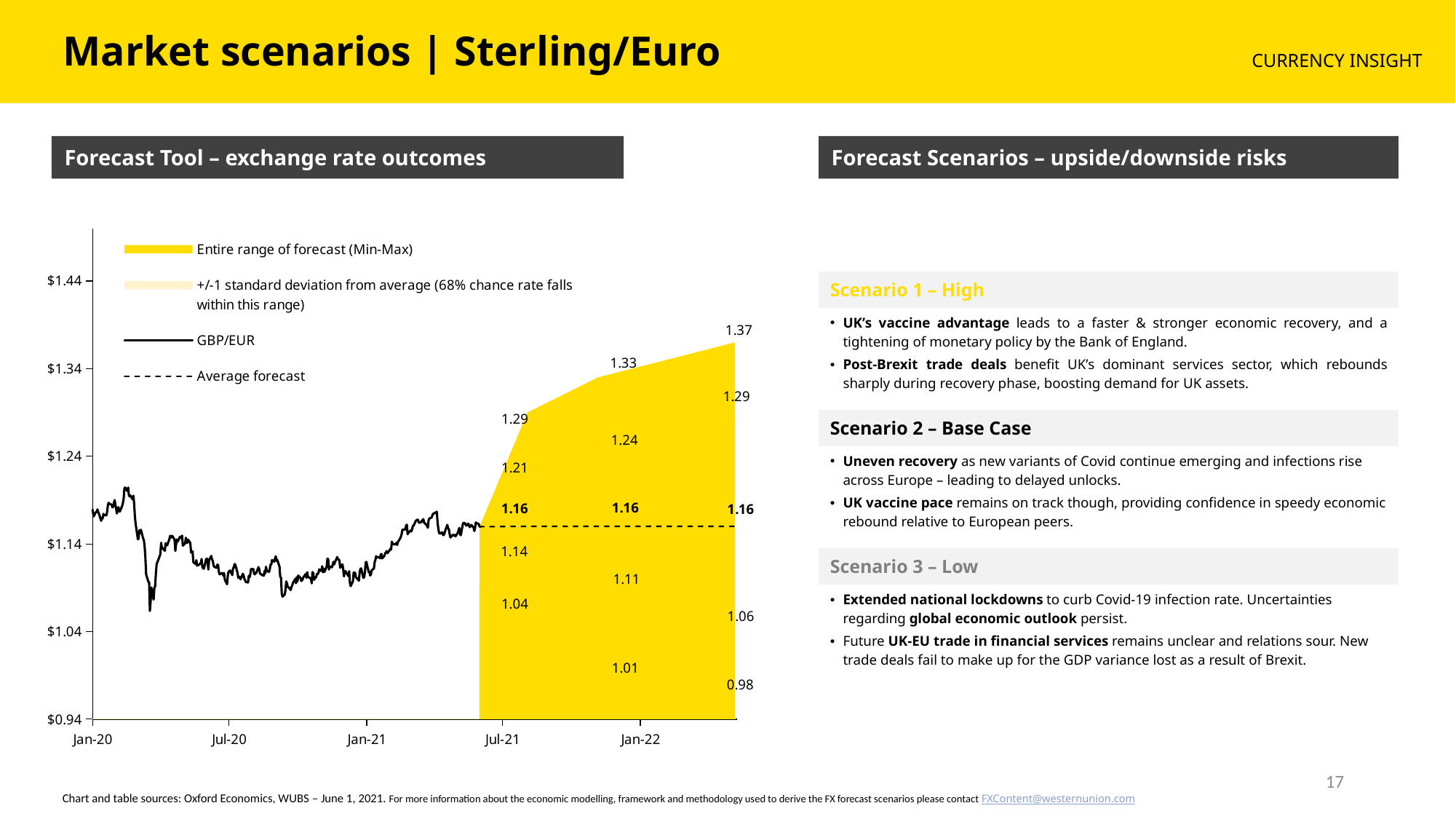
Does the upper bound of the forecast range rise or fall from Jul-21 to the end of the forecast? rise What is the difference between the highest (1.33) and lowest (1.01) labelled forecast values at Jan-22? 0.32 What colour represents the 'Entire range of forecast (Min-Max)' in the legend? yellow How many entries does the chart legend list? 4 What is the average forecast value shown along the dashed line? 1.16 What is the difference between the highest (1.37) and lowest (0.98) labelled forecast values? 0.39 What is the highest value labelled on the forecast range? 1.37 Is the GBP/EUR rate at Jan-20 greater or less than $1.14? greater What kind of chart is shown under 'Forecast Tool – exchange rate outcomes'? line chart What is the lowest value labelled on the forecast range? 0.98 What is the lowest labelled forecast value at Jan-22? 1.01 Which is larger: the upper forecast bound at Jan-22 (1.33) or at Jul-21 (1.29)? Jan-22 (1.33)